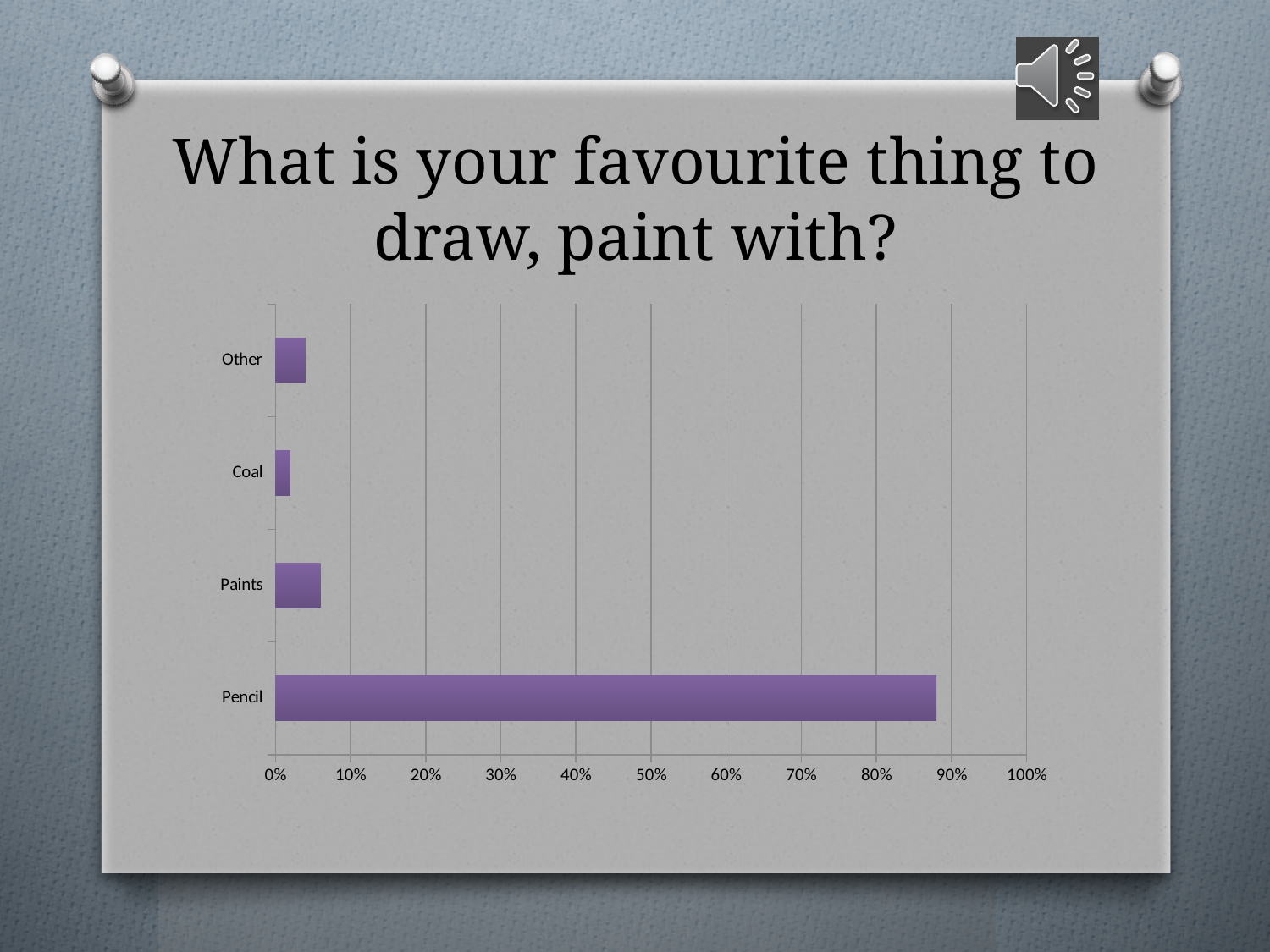
What is the title of the slide containing the chart? What is your favourite thing to draw, paint with? Which category has the highest value? Pencil What is the highest value shown on the horizontal axis? 100% What kind of chart is shown on the slide? bar chart Which has a larger value, Pencil or Paints? Pencil How many categories are shown on the chart? 4 Is the value for Paints greater or less than 10%? less Is the value for Pencil greater or less than 90%? less Is the value for Pencil greater or less than 80%? greater Which category has the lowest value? Coal Which has a larger value, Paints or Coal? Paints